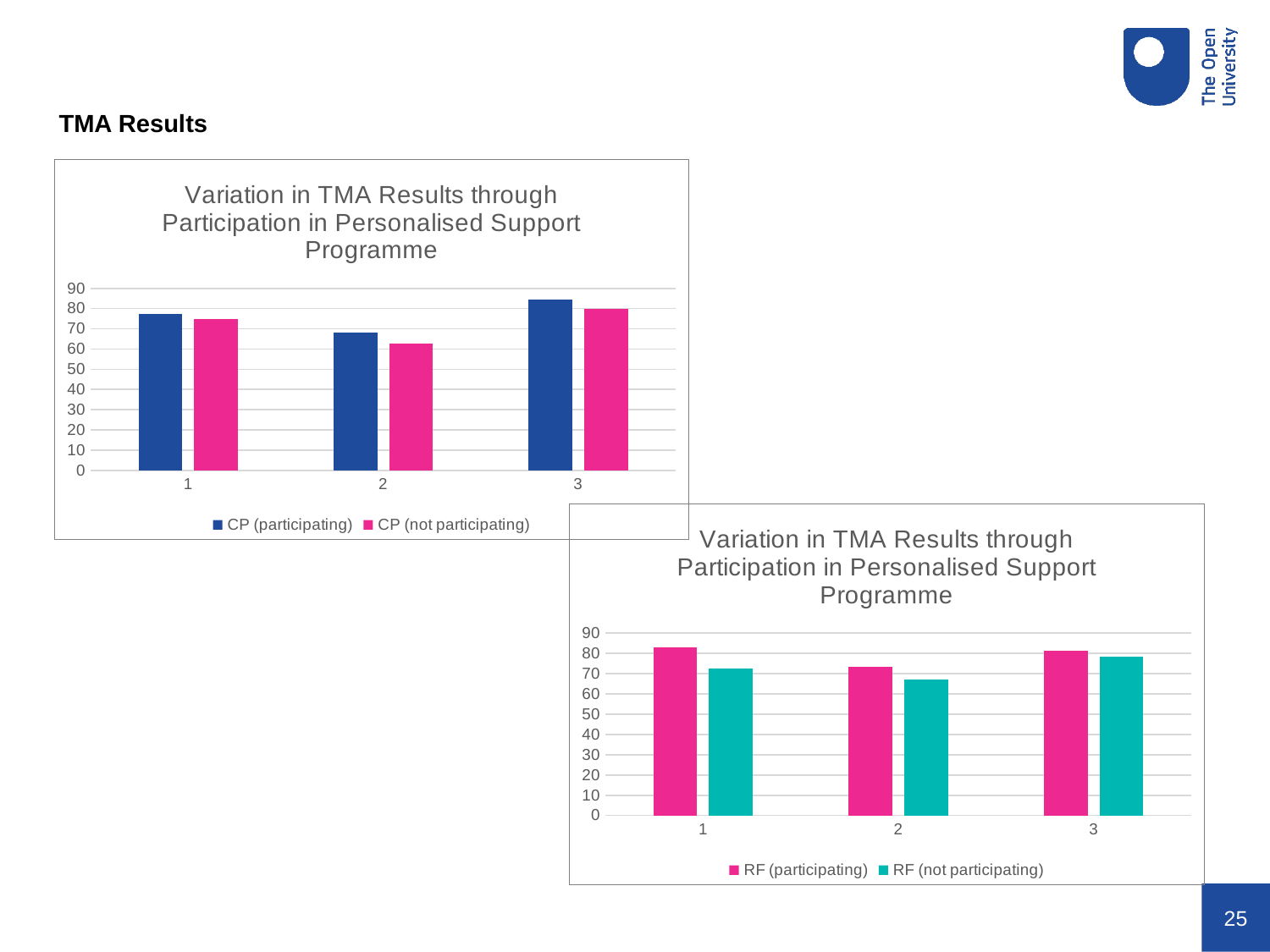
In the top-left chart, at category 1, which is larger: CP (participating) or CP (not participating)? CP (participating) In the bottom-right chart, at category 1, which is larger: RF (participating) or RF (not participating)? RF (participating) In the bottom-right chart, is the value for RF (not participating) at category 1 greater or less than 80? less What kind of chart is the top-left chart on the slide? bar chart In the top-left chart, how many categories are shown on the x axis? 3 In the top-left chart, how many series does the legend list? 2 In the top-left chart, is the value for CP (not participating) at category 2 greater or less than 70? less In the top-left chart, which category has the lowest value for CP (not participating)? 2 In the bottom-right chart, which category has the lowest value for RF (not participating)? 2 What is the title of the bottom-right chart? Variation in TMA Results through Participation in Personalised Support Programme In the bottom-right chart, how many series does the legend list? 2 In the top-left chart, which category has the highest value for CP (participating)? 3